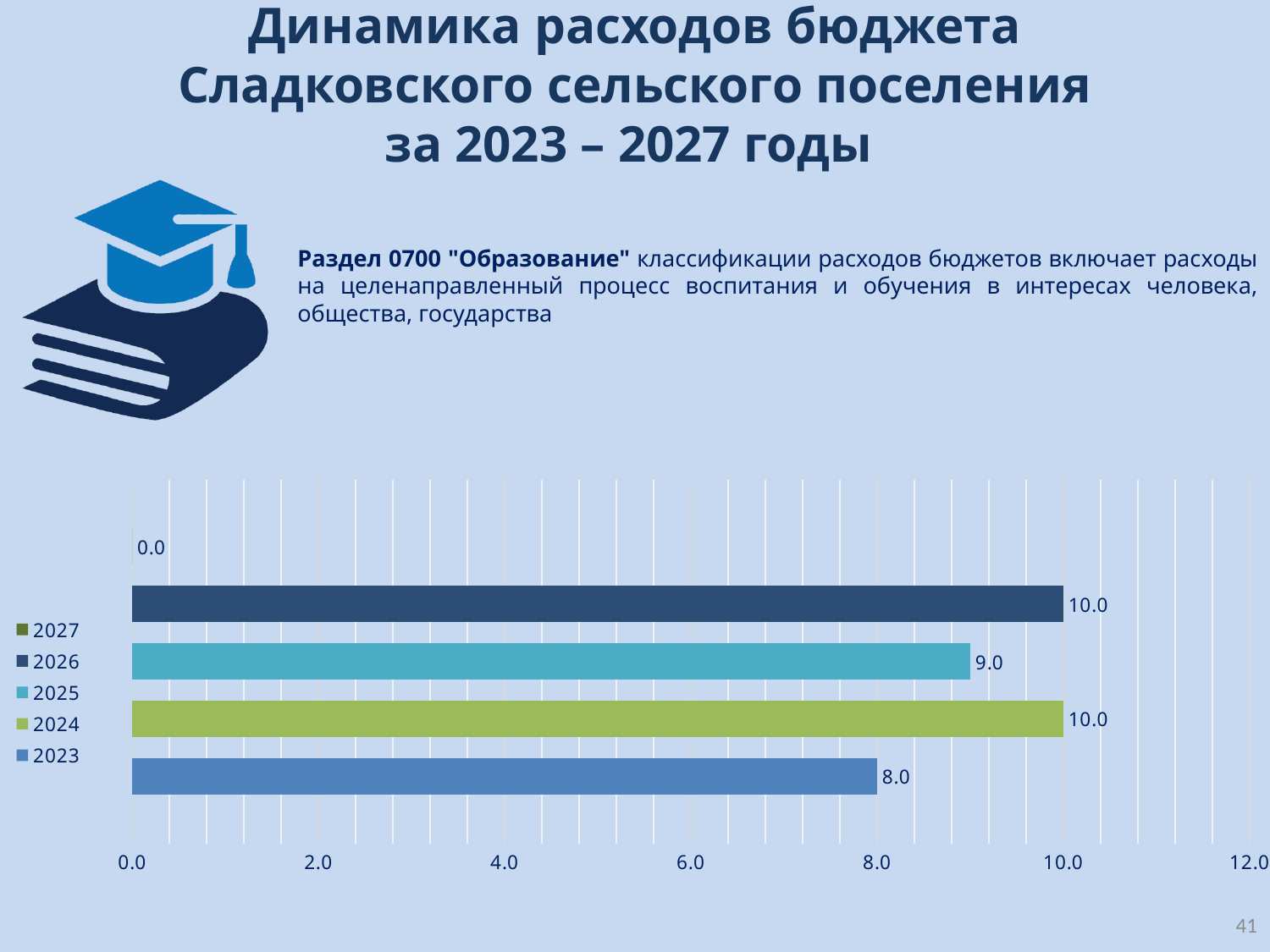
How many series does the legend list? 5 What is the difference between the values for 2025 and 2023? 1.0 What kind of chart is shown on the slide? bar chart What is the value for 2027? 0.0 What is the maximum value shown on the horizontal axis? 12.0 What is the value for 2026? 10.0 What is the difference between the values for 2026 and 2025? 1.0 Which year has the lowest value? 2027 Which is larger, the value for 2024 or the value for 2023? 2024 What is the value for 2025? 9.0 What is the value for 2024? 10.0 What is the value for 2023? 8.0